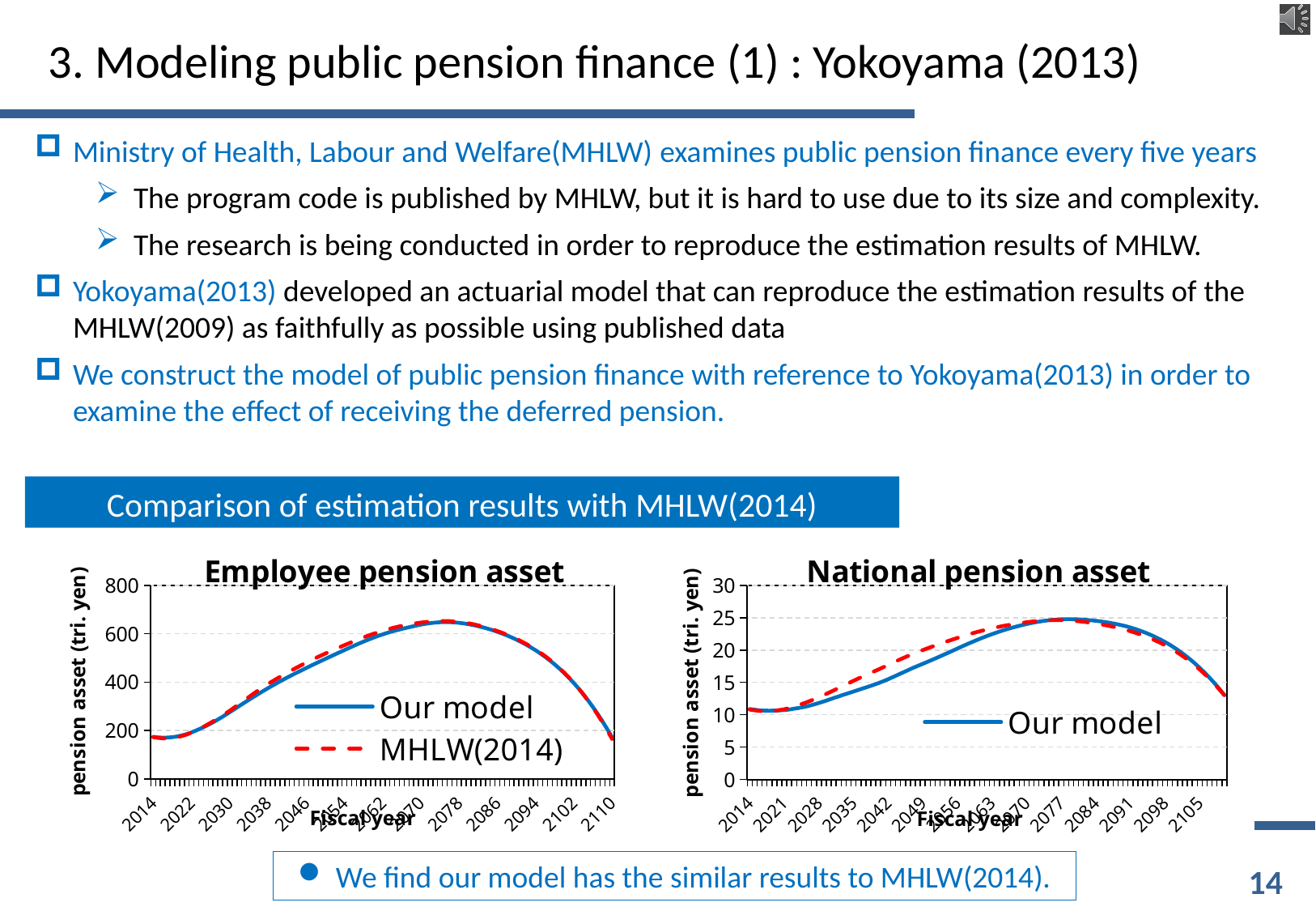
In the "Employee pension asset" chart, is the peak value of Our model greater or less than 600? greater In the "Employee pension asset" chart, is the value of Our model in 2014 greater or less than 200? less What is the y-axis label of the "Employee pension asset" chart? pension asset (tri. yen) What kind of chart is the "Employee pension asset" chart? Line chart In the "National pension asset" chart, is the value of Our model in 2105 greater or less than 15? greater What kind of chart is the "National pension asset" chart? Line chart How many series does the legend of the "Employee pension asset" chart list? 2 In the "Employee pension asset" chart, which series is drawn as a red dashed line? MHLW(2014) How many series does the legend of the "National pension asset" chart list? 1 In the "Employee pension asset" chart, does the Our model line rise or fall between 2030 and 2070? rise In the "National pension asset" chart, does the Our model line rise or fall between 2084 and 2105? fall